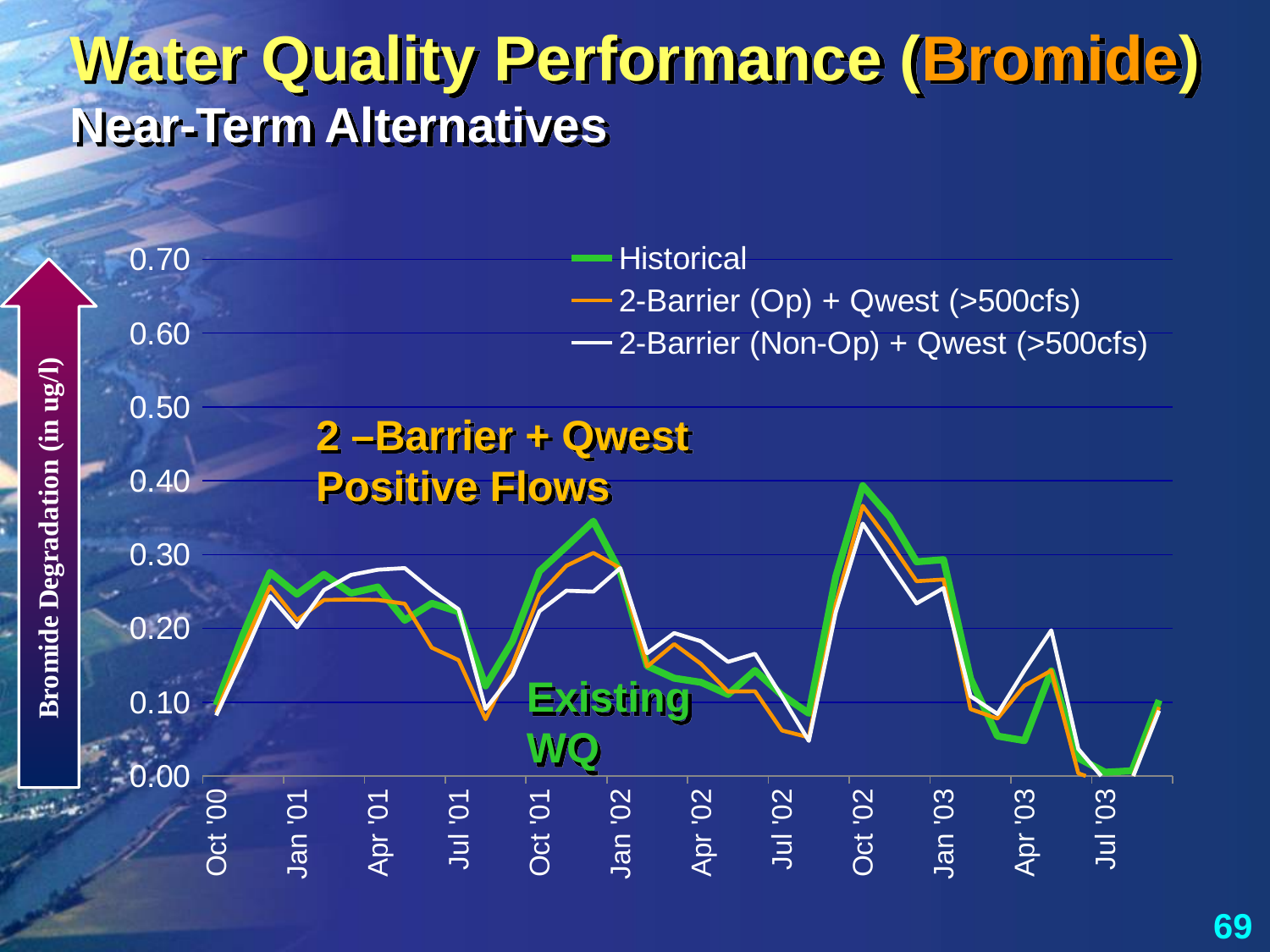
Is the value of the Historical series at Jul '03 greater or less than 0.10? less What is the highest value shown on the vertical axis? 0.70 At Oct '02, which series has the larger value: Historical or 2-Barrier (Non-Op) + Qwest (>500cfs)? Historical What is the label on the vertical axis? Bromide Degradation (in ug/l) At which x-axis label does the Historical series reach its highest value? Oct '02 Is the value of the Historical series at Oct '00 greater or less than 0.20? less How many series does the legend list? 3 Is the value of the Historical series at Oct '02 greater or less than 0.30? greater How many labeled tick marks are on the x axis? 12 What kind of chart is shown on the slide? Line chart Does the Historical series rise or fall from Oct '02 to Jul '03? Fall Which series is drawn in green? Historical